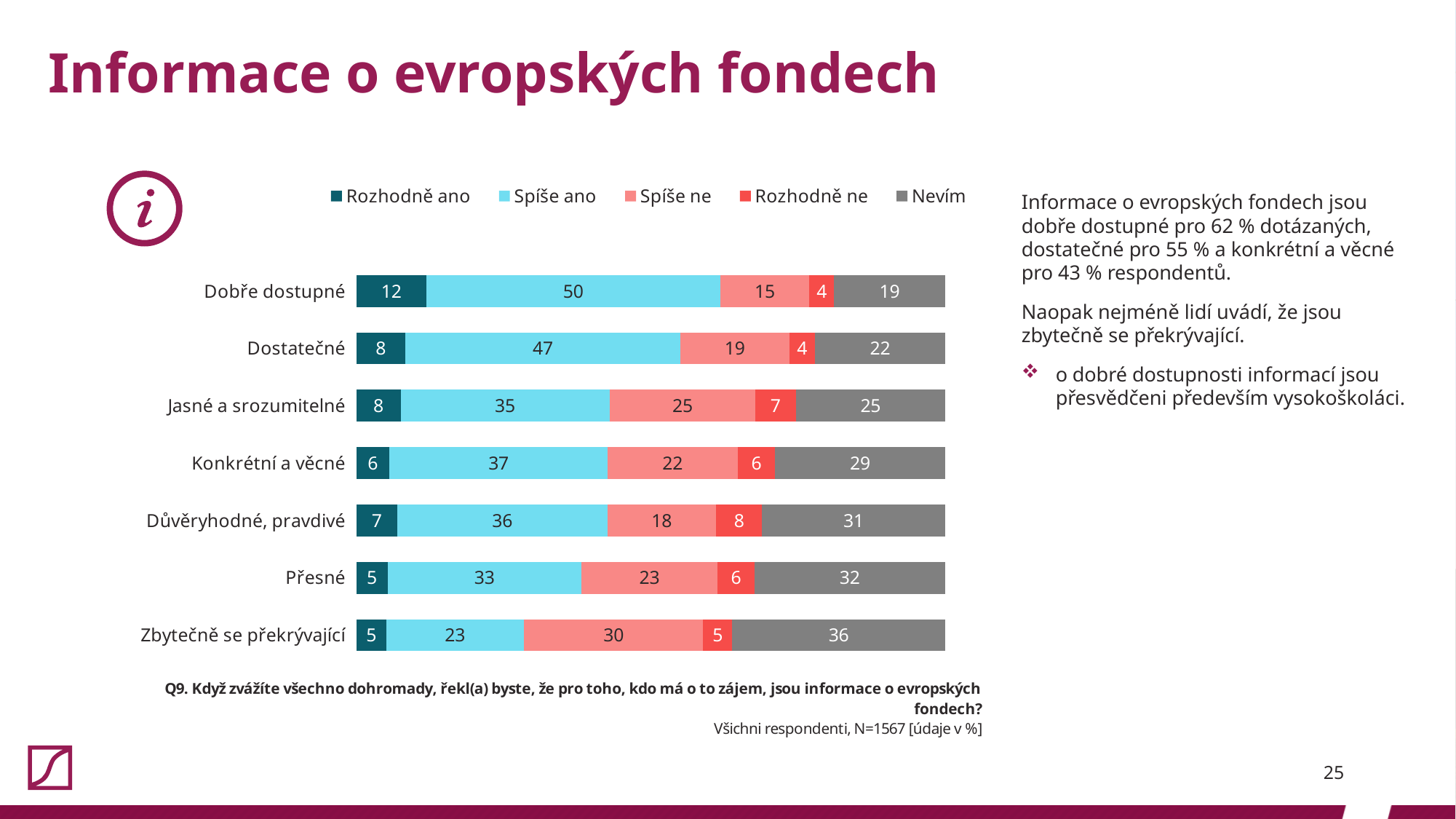
Which legend entry is shown in grey? Nevím How many series does the legend list? 5 Which category has the highest value for "Rozhodně ano"? Dobře dostupné What is the value of "Nevím" for "Zbytečně se překrývající"? 36 Which category has the lowest value for "Spíše ano"? Zbytečně se překrývající What is the difference between the "Spíše ano" values for "Dobře dostupné" and "Dostatečné"? 3 What is the value of "Spíše ano" for "Dobře dostupné"? 50 Which has the larger "Spíše ne" value: "Zbytečně se překrývající" or "Jasné a srozumitelné"? Zbytečně se překrývající How many categories are shown in the chart? 7 What is the value of "Rozhodně ne" for "Důvěryhodné, pravdivé"? 8 What kind of chart is shown on the slide? Stacked bar chart What is the total of the stacked bar for "Přesné"? 99